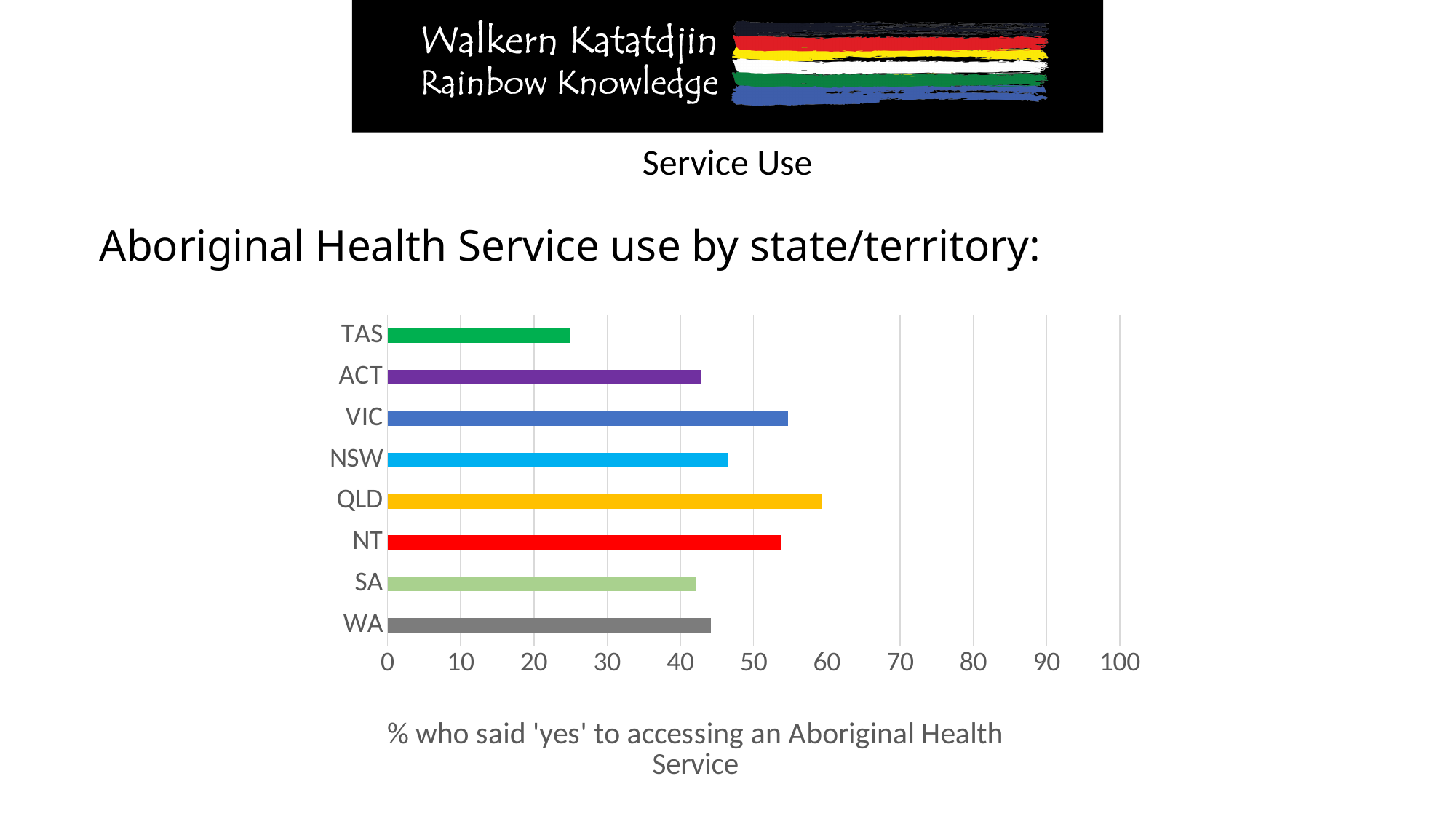
Is the value for WA greater or less than 50? less Is the value for NSW greater or less than 50? less Is the value for QLD greater or less than 50? greater Which state/territory has the highest percentage who said 'yes' to accessing an Aboriginal Health Service? QLD What kind of chart is shown on the slide? bar chart How many states/territories are shown in the chart? 8 Which state/territory has the lowest percentage who said 'yes' to accessing an Aboriginal Health Service? TAS Which has a higher value, SA or NT? NT What is the label shown below the horizontal axis of the chart? % who said 'yes' to accessing an Aboriginal Health Service Which has a higher value, TAS or ACT? ACT